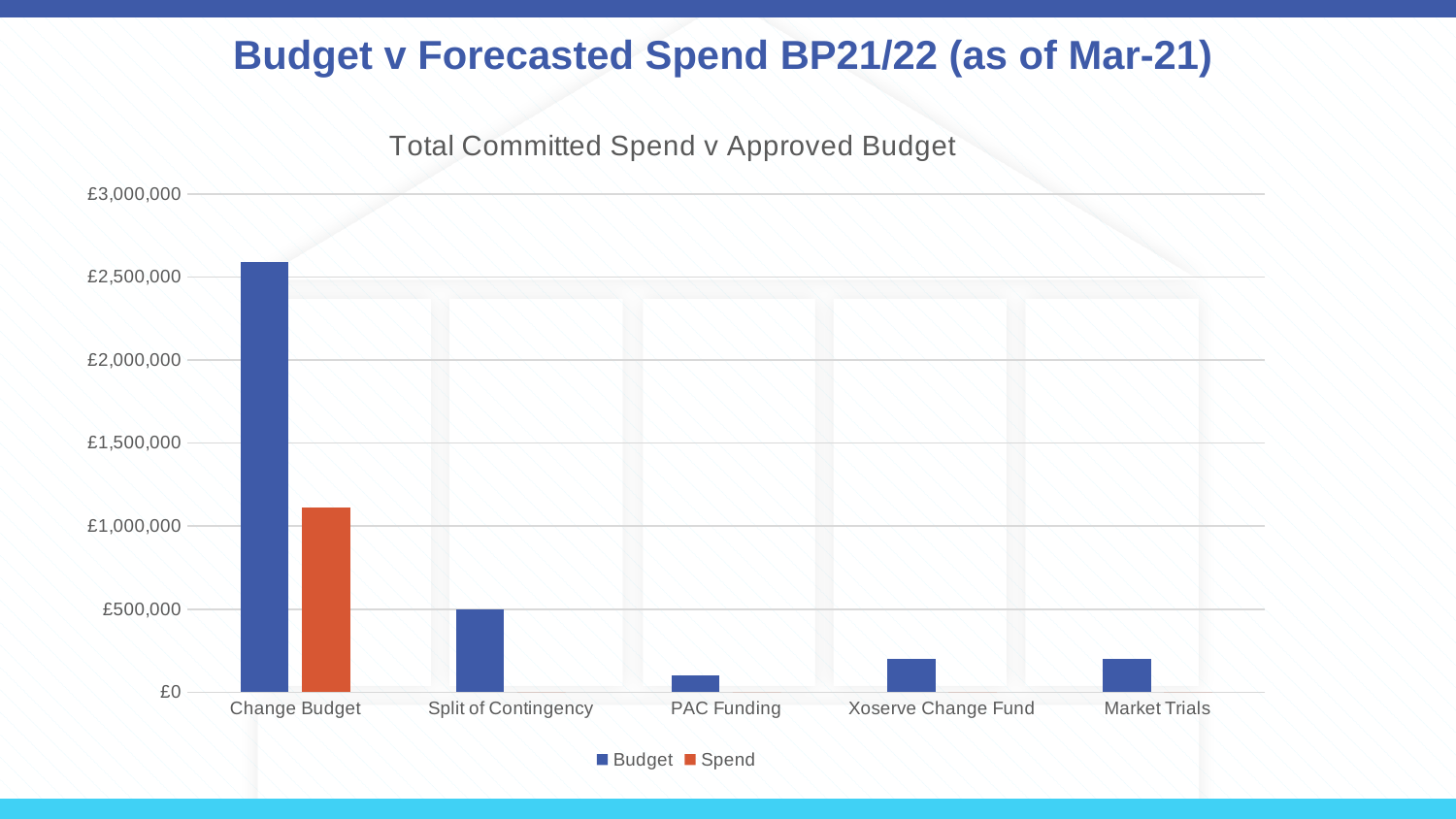
What is the title of the chart? Total Committed Spend v Approved Budget Is the Budget value for PAC Funding greater or less than £500,000? less How many series does the legend list? 2 Is the Spend value for Change Budget greater or less than £1,000,000? greater Which colour represents the Spend series in the legend? Orange Is the Budget value for Xoserve Change Fund greater or less than £500,000? less Which category has the highest Budget value? Change Budget Which category has the lowest Budget value? PAC Funding For Change Budget, which is larger, the Budget value or the Spend value? Budget How many categories are shown on the x axis? 5 What kind of chart is shown on the slide? Bar chart